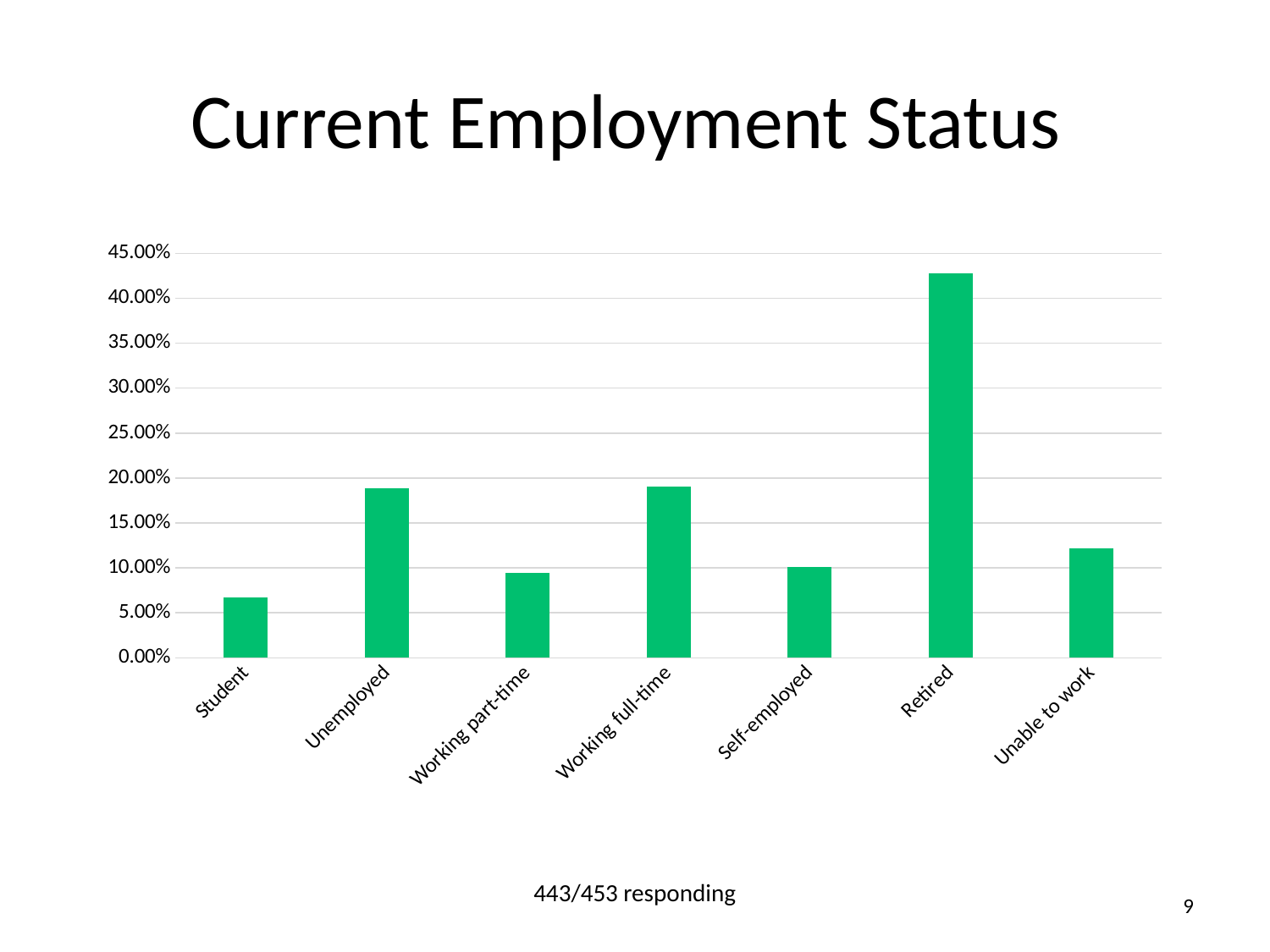
Which employment status has the highest value? Retired Is the value for Unemployed greater or less than 15.00%? greater Is the value for Student greater or less than 10.00%? less Is the value for Retired greater or less than 40.00%? greater Which is larger, the value for Unable to work or the value for Student? Unable to work Which employment status has the lowest value? Student Which is larger, the value for Working full-time or the value for Self-employed? Working full-time How many employment status categories are shown on the x axis? 7 What is the title of the chart? Current Employment Status What kind of chart is shown on the slide? bar chart